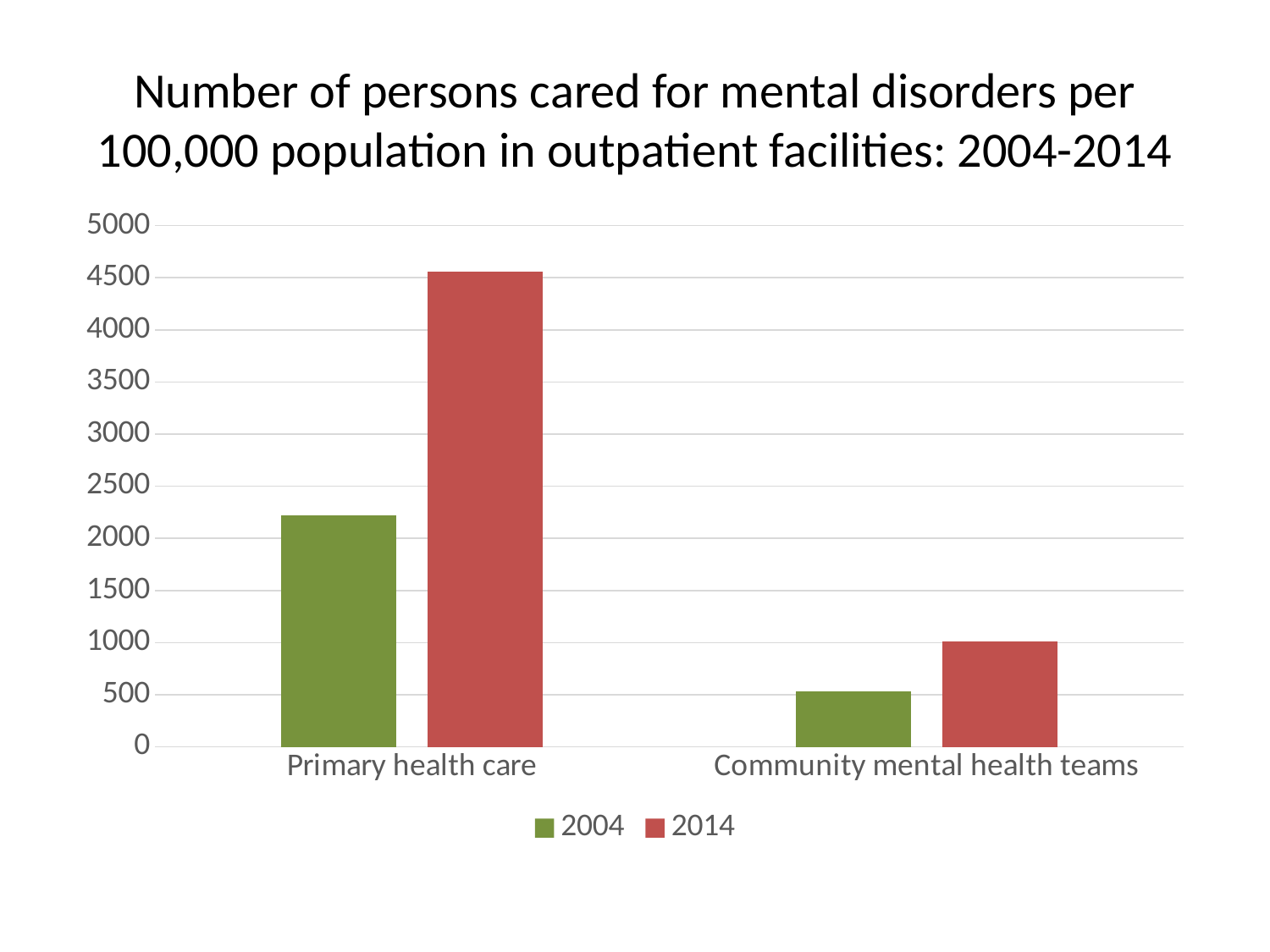
Is the value for Primary health care in 2004 greater or less than 2500? less Is the value for Community mental health teams in 2004 greater or less than 1000? less For Community mental health teams, which year has the larger value, 2004 or 2014? 2014 Is the value for Primary health care in 2014 greater or less than 4000? greater What colour are the bars for 2014? red Which category has the highest value for 2014? Primary health care Which series does the legend list first? 2004 How many categories are shown on the x axis? 2 What kind of chart is shown on the slide? bar chart How many series does the legend list? 2